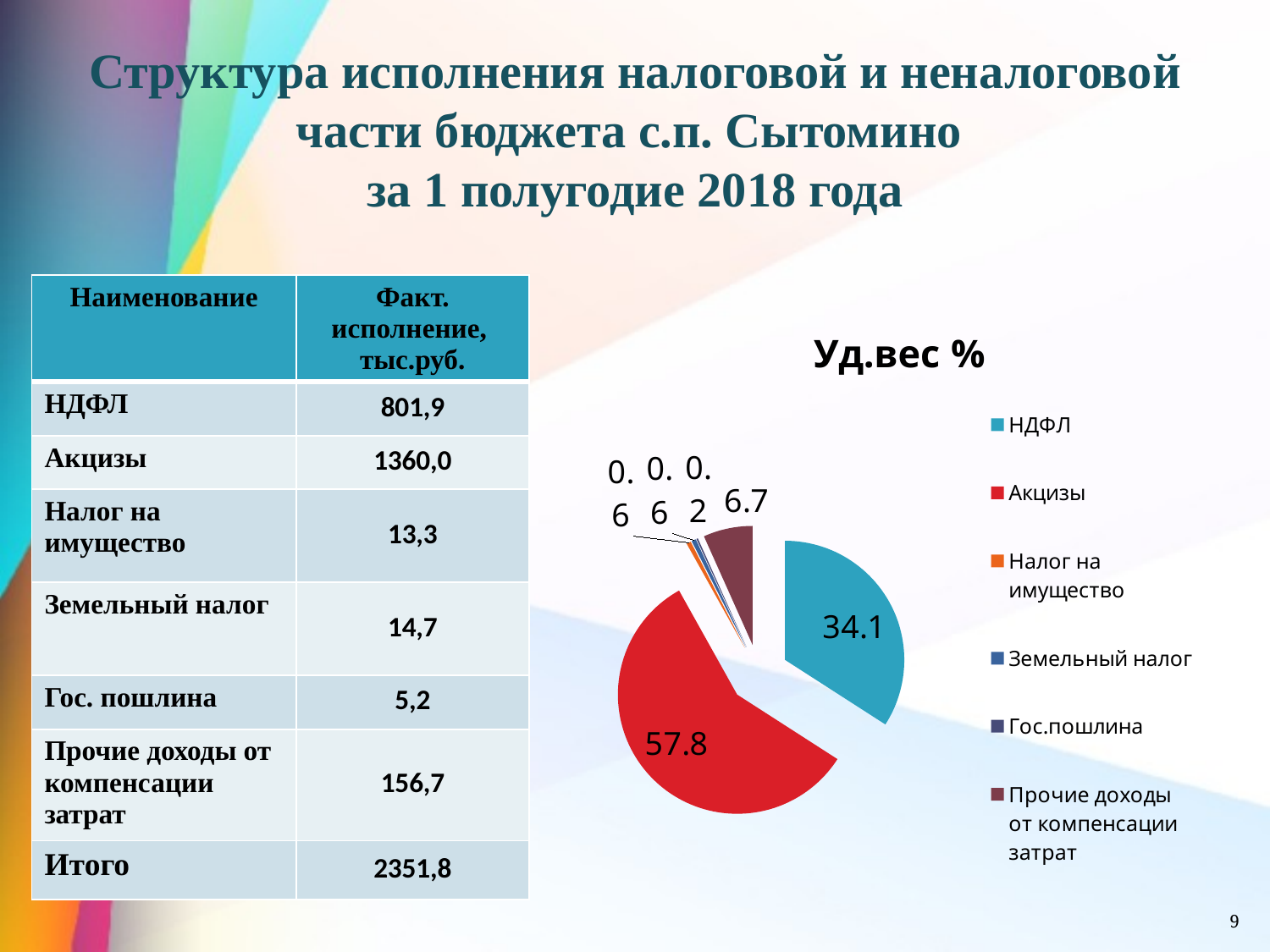
What is the value shown for Прочие доходы от компенсации затрат in the pie chart? 6.7 Which is larger in the pie chart, НДФЛ or Акцизы? Акцизы Which category has the largest slice in the pie chart? Акцизы What colour is the Акцизы slice in the pie chart? red What is the difference between the values for НДФЛ and Прочие доходы от компенсации затрат in the pie chart? 27.4 What is the difference between the values for Акцизы and НДФЛ in the pie chart? 23.7 What is the title of the pie chart? Уд.вес % How many categories does the legend of the pie chart list? 6 What is the value shown for НДФЛ in the pie chart? 34.1 Which is larger in the pie chart, НДФЛ or Прочие доходы от компенсации затрат? НДФЛ What kind of chart is shown under the title "Уд.вес %"? pie chart What is the value shown for Акцизы in the pie chart? 57.8